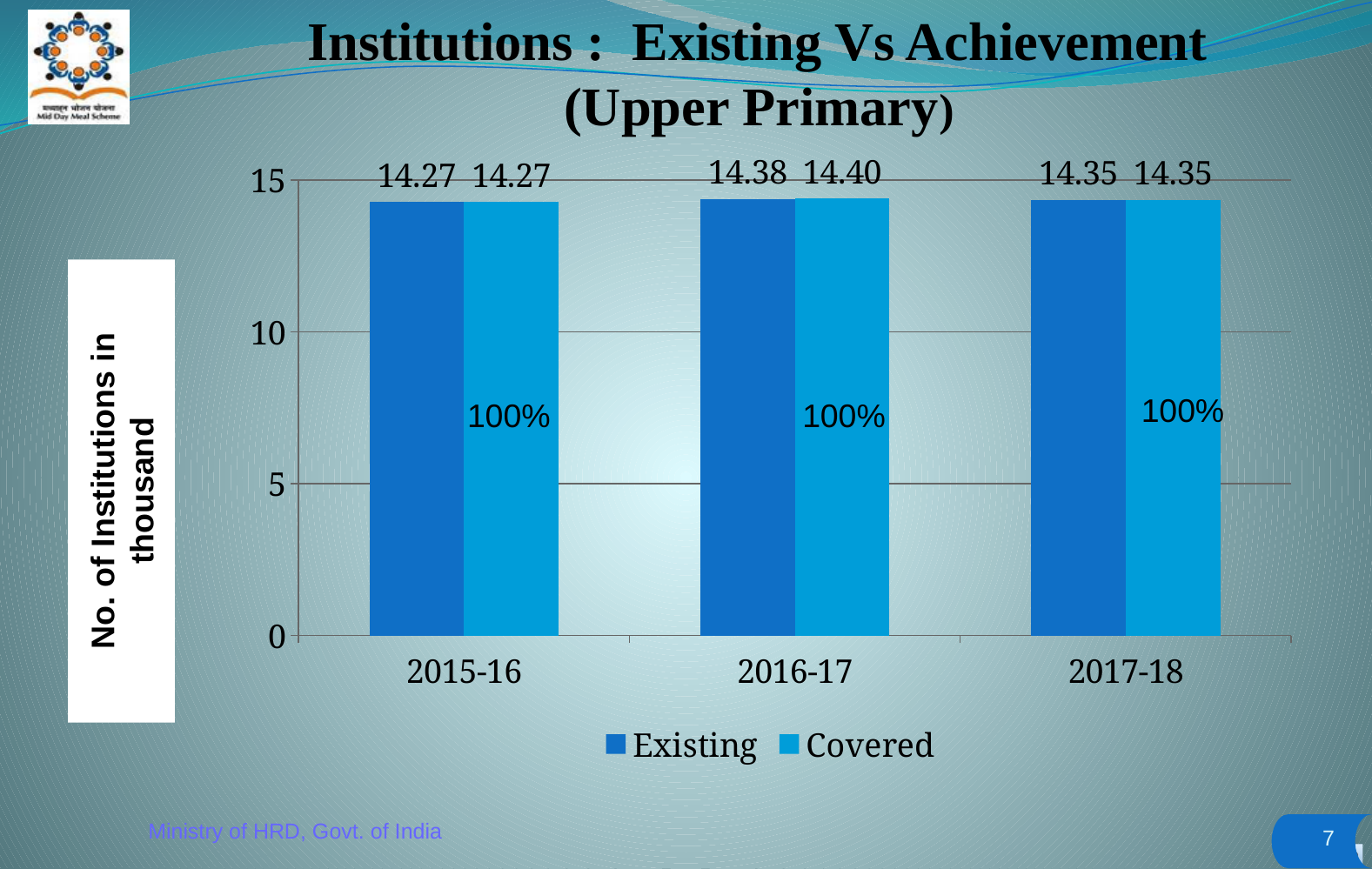
What is the Existing value for 2015-16? 14.27 What kind of chart is shown on the slide? bar chart What is the title of the chart? Institutions : Existing Vs Achievement (Upper Primary) How many series does the legend list? 2 What is the Covered value for 2016-17? 14.40 Which year has the lowest Covered value? 2015-16 What is the y-axis label of the chart? No. of Institutions in thousand Which year has the highest Existing value? 2016-17 Is the Covered value for 2017-18 greater or less than 10? greater What is the Existing value for 2017-18? 14.35 What is the difference between the Existing values for 2016-17 and 2015-16? 0.11 How many years are shown on the x axis? 3